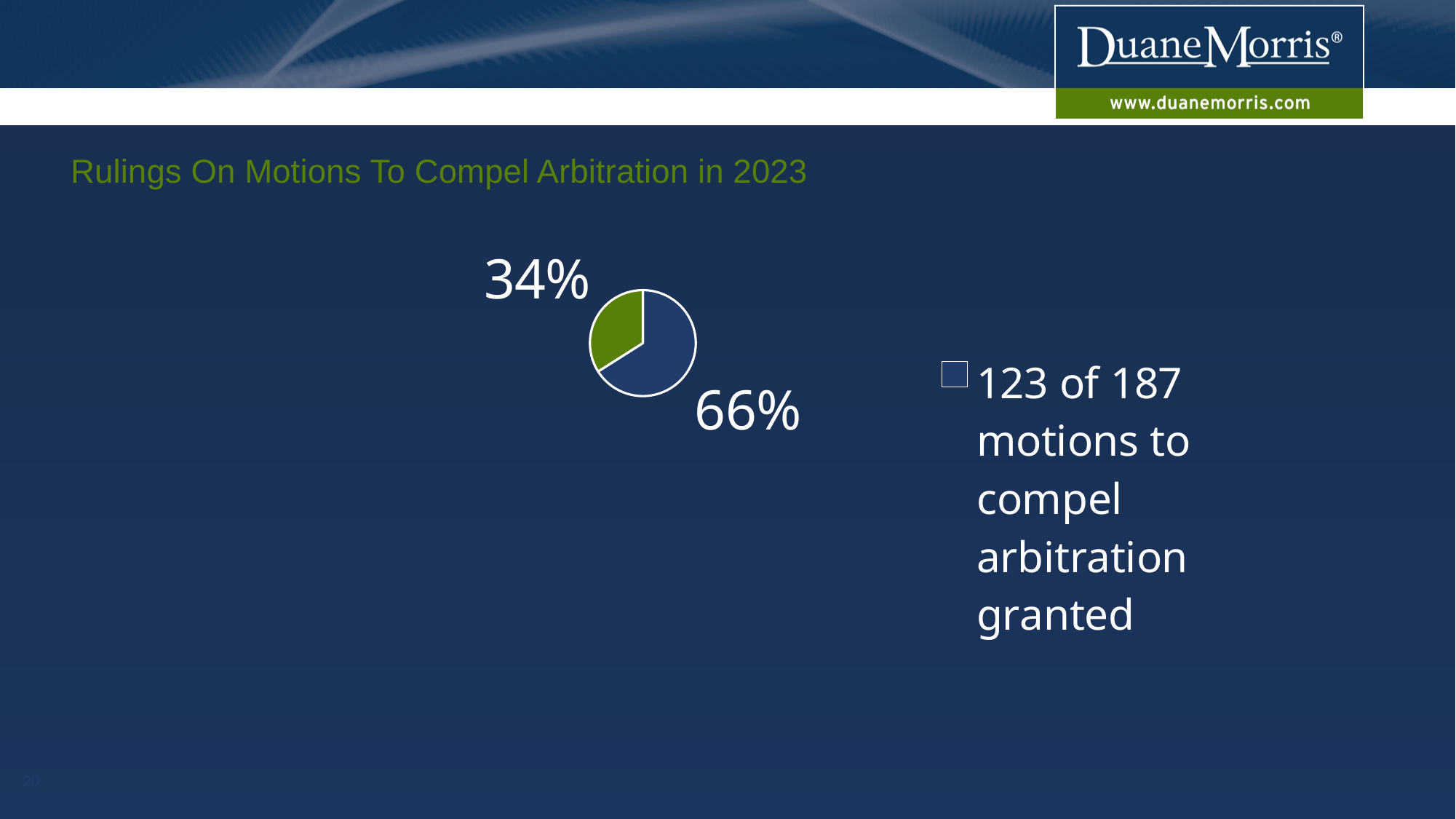
Which slice of the pie is larger, the blue slice or the green slice? the blue slice What does the legend entry next to the blue square say? 123 of 187 motions to compel arbitration granted What kind of chart is shown on the slide? pie chart How many entries does the chart's legend list? 1 What percentage is shown for the blue slice of the pie chart? 66% Which slice of the pie chart is the smallest? the green slice (34%) What percentage is shown for the green slice of the pie chart? 34% What is the title of the chart on the slide? Rulings On Motions To Compel Arbitration in 2023 What share of the pie does the slice for "123 of 187 motions to compel arbitration granted" represent? 66% What is the difference in percentage points between the 66% slice and the 34% slice? 32 percentage points How many slices does the pie chart have? 2 Is the share of the blue slice greater or less than 50%? greater